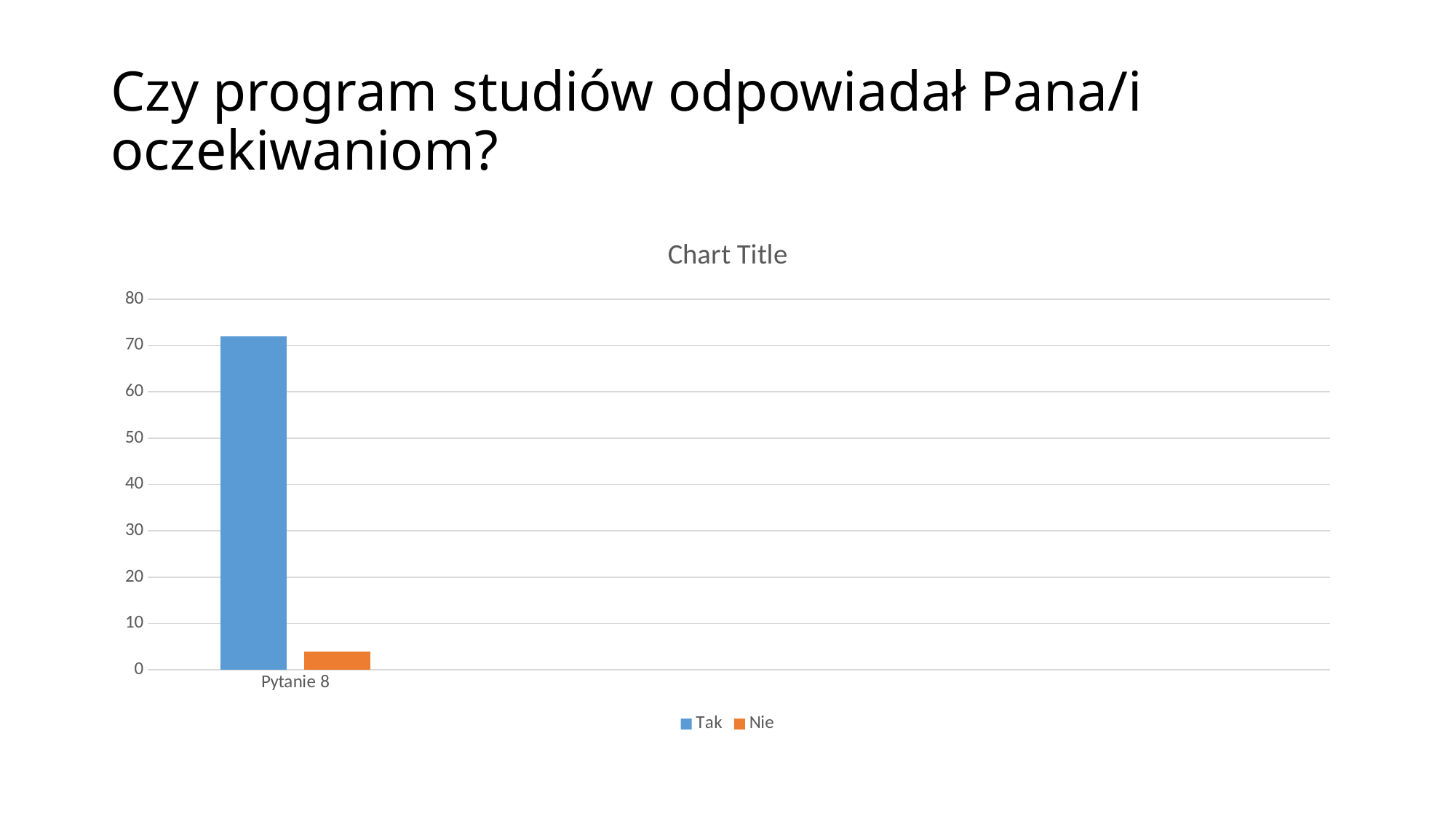
Which series has the higher value for Pytanie 8? Tak Which series has the lower value for Pytanie 8? Nie What kind of chart is shown on the slide? bar chart How many categories are shown on the x axis? 1 Is the value for Tak greater or less than 80? less Is the value for Tak larger or smaller than the value for Nie? larger How many series does the legend list? 2 What colour is the bar for the Nie series? orange Is the value for Tak greater or less than 60? greater What is the category label shown on the x axis? Pytanie 8 Is the value for Nie greater or less than 10? less